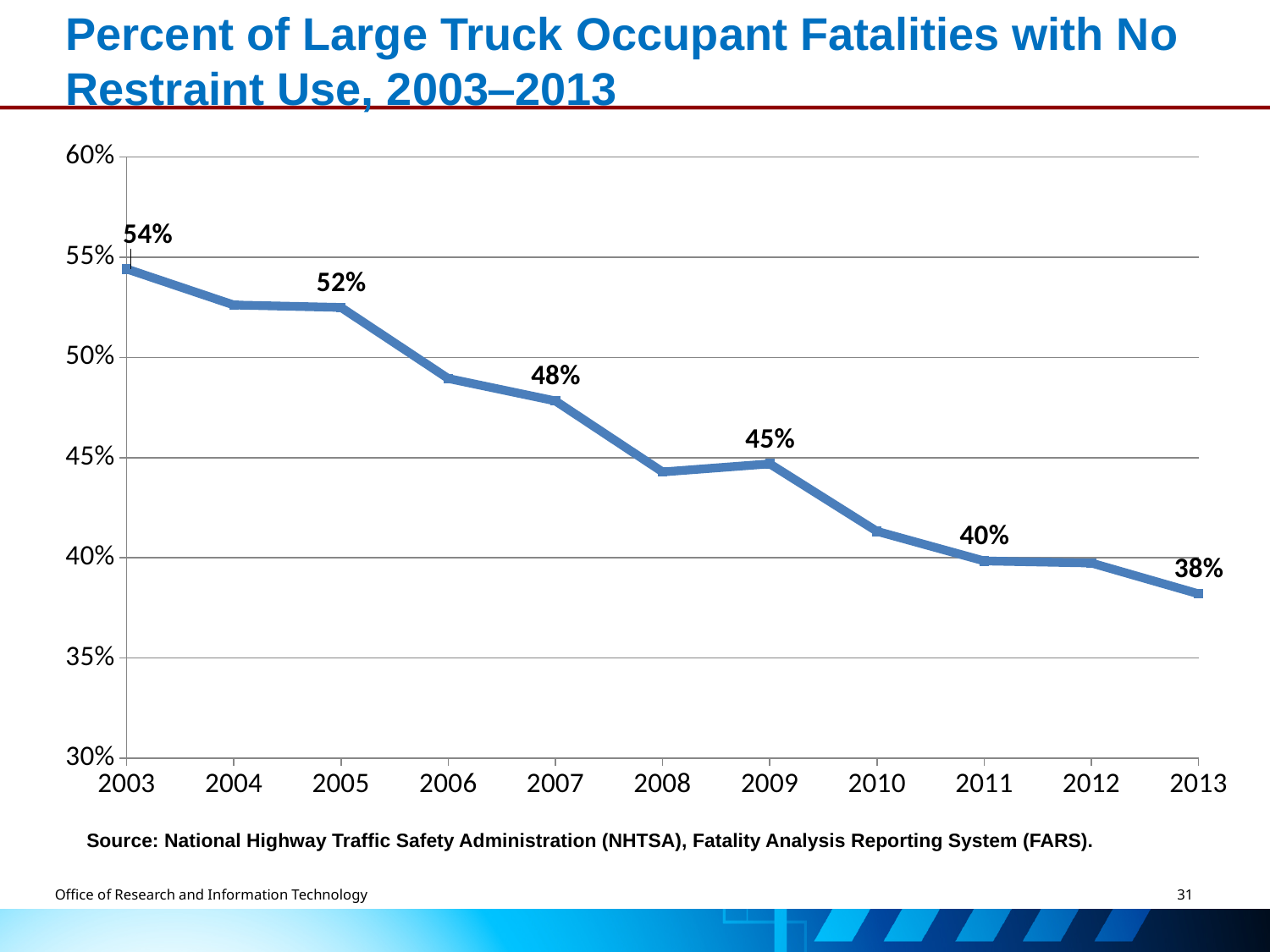
By how many percentage points did the value fall from 2003 to 2013? 16 percentage points Which year has the highest percent of fatalities with no restraint use? 2003 What is the value shown for 2013? 38% What is the percent of large truck occupant fatalities with no restraint use in 2003? 54% How many years are plotted on the x axis? 11 What is the value shown for 2009? 45% What type of chart is shown on the slide? Line chart Which year has the larger value, 2005 or 2011? 2005 Do the values generally rise or fall from 2003 to 2013? Fall Is the value for 2004 greater or less than 50%? greater Which year has the lowest percent of fatalities with no restraint use? 2013 What is the value shown for 2007? 48%